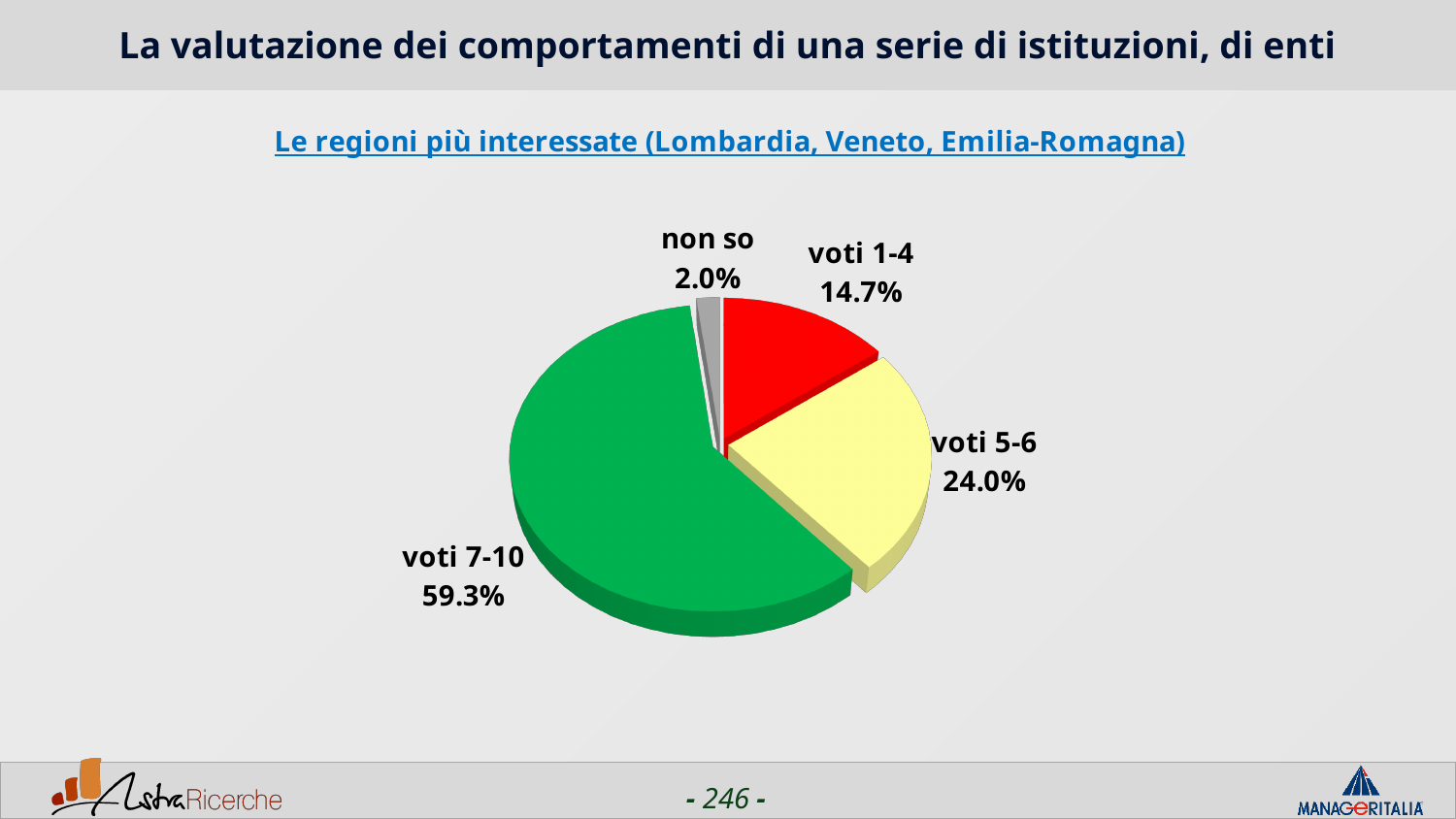
What is the difference between the 'voti 5-6' and 'voti 1-4' values? 9.3% What is the subtitle above the chart? Le regioni più interessate (Lombardia, Veneto, Emilia-Romagna) Which is larger, 'voti 5-6' or 'voti 1-4'? voti 5-6 Which slice of the pie is the smallest? non so What kind of chart is shown on the slide? Pie chart What is the value shown for 'voti 5-6'? 24.0% What colour is the 'voti 7-10' slice? Green What share of the pie does the 'voti 7-10' slice represent? 59.3% What is the value shown for 'non so'? 2.0% What is the value shown for 'voti 1-4'? 14.7% How many slices does the pie chart have? 4 Which slice of the pie is the largest? voti 7-10